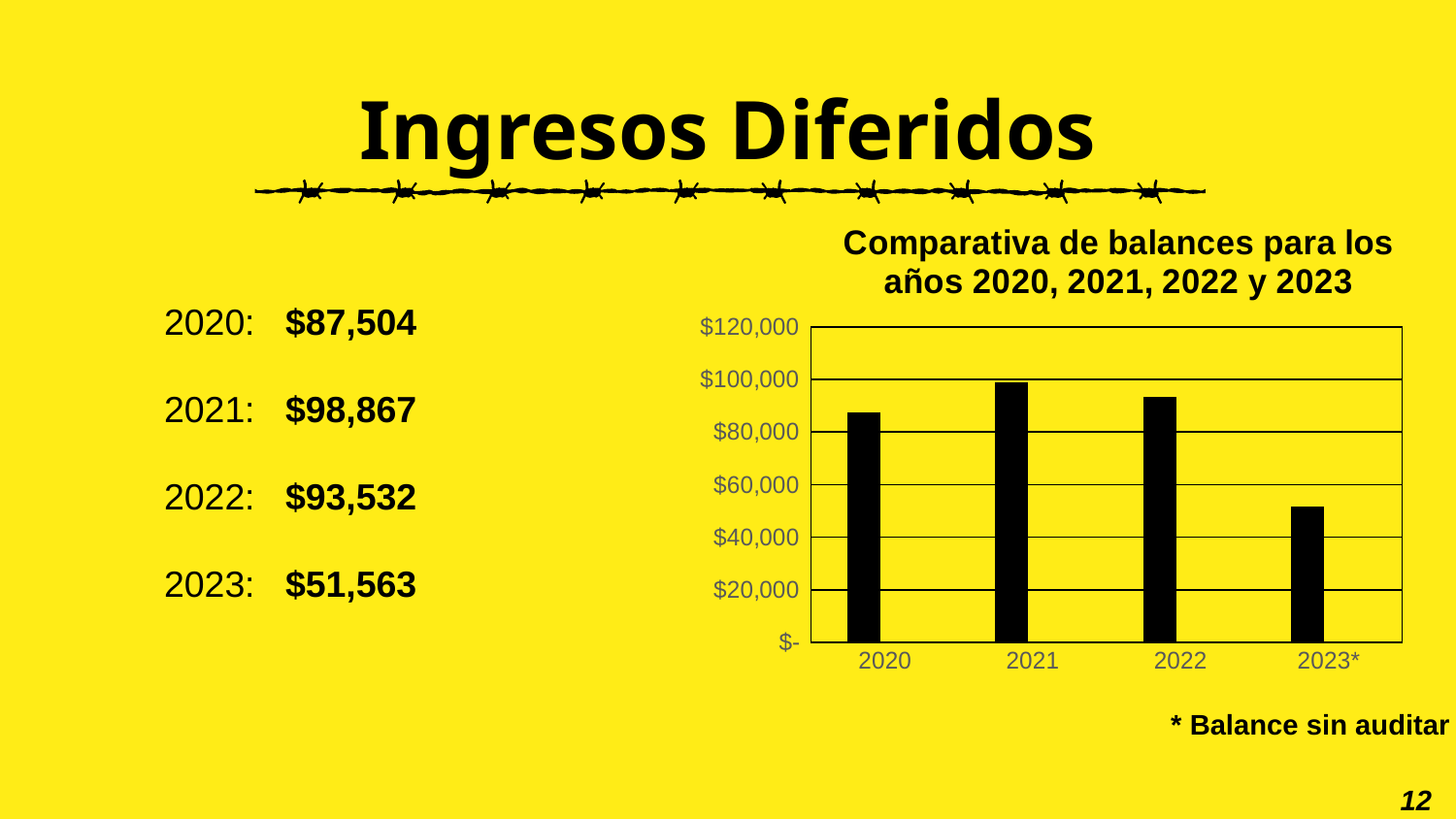
Which year has the highest value? 2021 How many bars (years) are plotted in the chart? 4 What type of chart is shown on the slide? Bar chart What does the asterisk next to 2023 on the x axis indicate? Balance sin auditar What is the title of the chart? Comparativa de balances para los años 2020, 2021, 2022 y 2023 Which is larger, the value for 2020 or the value for 2022? 2022 What is the difference between the values for 2021 and 2022? $5,335 What is the value for 2020? $87,504 What is the value for 2023? $51,563 Is the value for 2023 greater or less than $60,000? less What is the value for 2021? $98,867 Which year has the lowest value? 2023